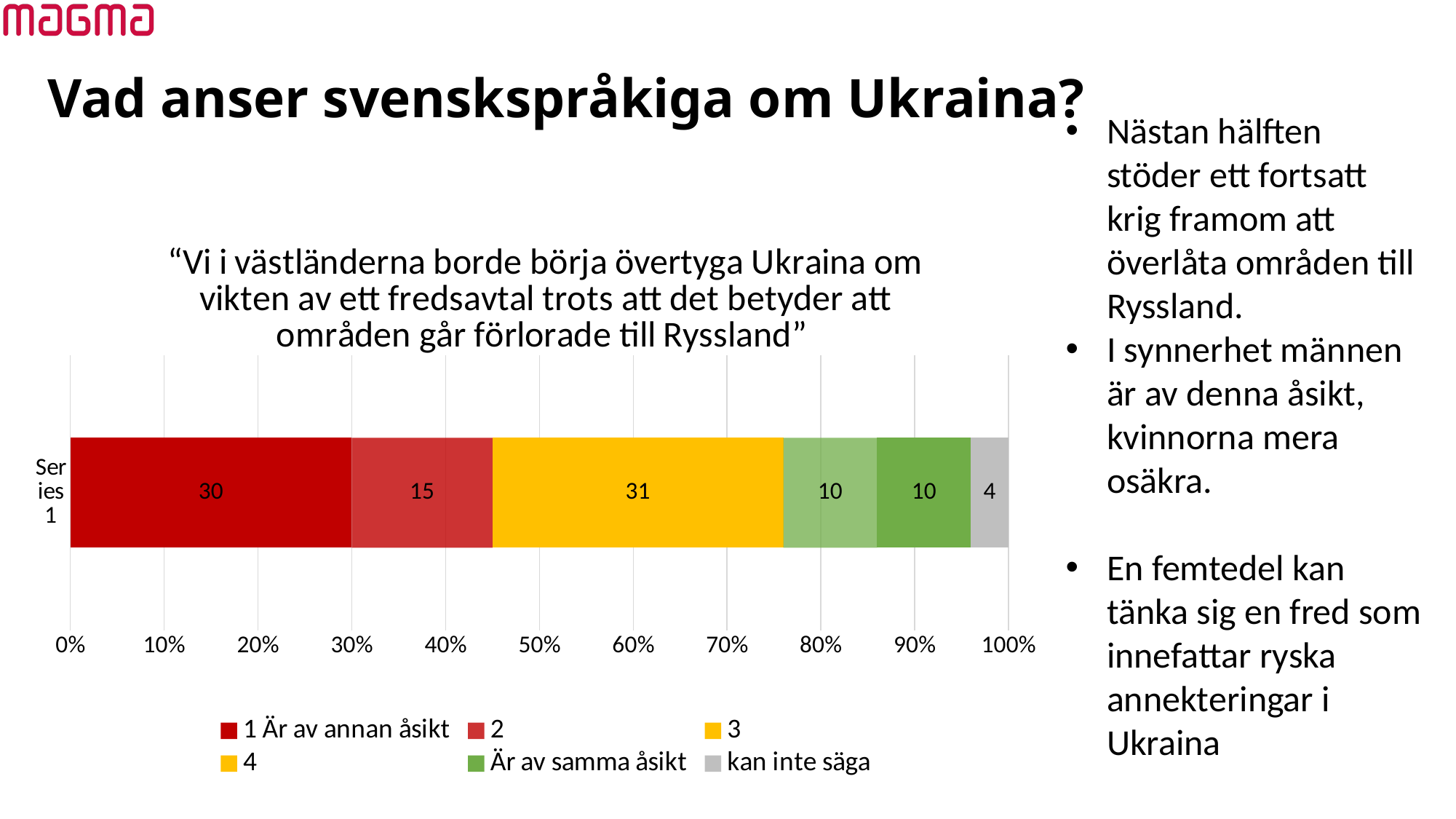
What is the total of all segments in the stacked bar? 100 What is the value of the "3" segment in the stacked bar? 31 Which is larger, the "2" segment or the "kan inte säga" segment? 2 Which legend category has the largest segment in the bar? 3 What is the difference between the "1 Är av annan åsikt" segment and the "2" segment? 15 What is the difference between the "3" segment and the "1 Är av annan åsikt" segment? 1 How many series does the legend list? 6 What is the value of the "2" segment in the stacked bar? 15 What kind of chart is shown on the slide? Stacked bar chart What is the value of the "kan inte säga" segment in the stacked bar? 4 Which legend category has the smallest segment in the bar? kan inte säga What is the value of the "1 Är av annan åsikt" segment in the stacked bar? 30